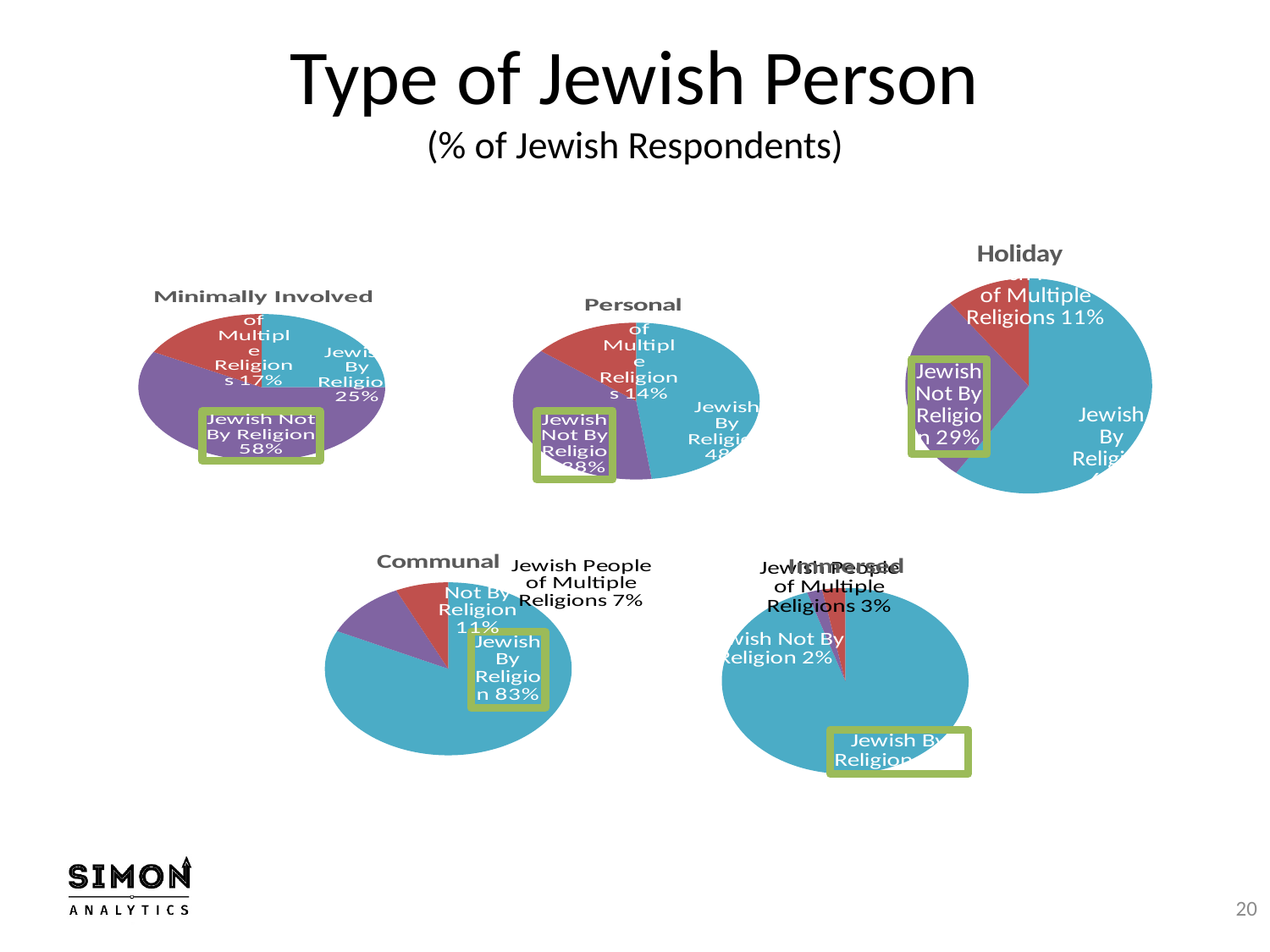
In the Immersed pie chart, which is larger: Jewish People of Multiple Religions or Jewish Not By Religion? Jewish People of Multiple Religions In the Minimally Involved pie chart, what share is Jewish People of Multiple Religions? 17% In the Minimally Involved pie chart, what share is Jewish Not By Religion? 58% What kind of chart is used for the Minimally Involved group? Pie chart In the Communal pie chart, what share is Jewish By Religion? 83% In the Personal pie chart, what share is Jewish People of Multiple Religions? 14% In the Communal pie chart, how much larger is the Jewish Not By Religion share than the Jewish People of Multiple Religions share? 4% In the Minimally Involved pie chart, which category has the largest share? Jewish Not By Religion How many pie charts are shown on the slide? 5 In the Holiday pie chart, what share is Jewish Not By Religion? 29% In the Holiday pie chart, what share is Jewish People of Multiple Religions? 11% In the Minimally Involved pie chart, what share is Jewish By Religion? 25%